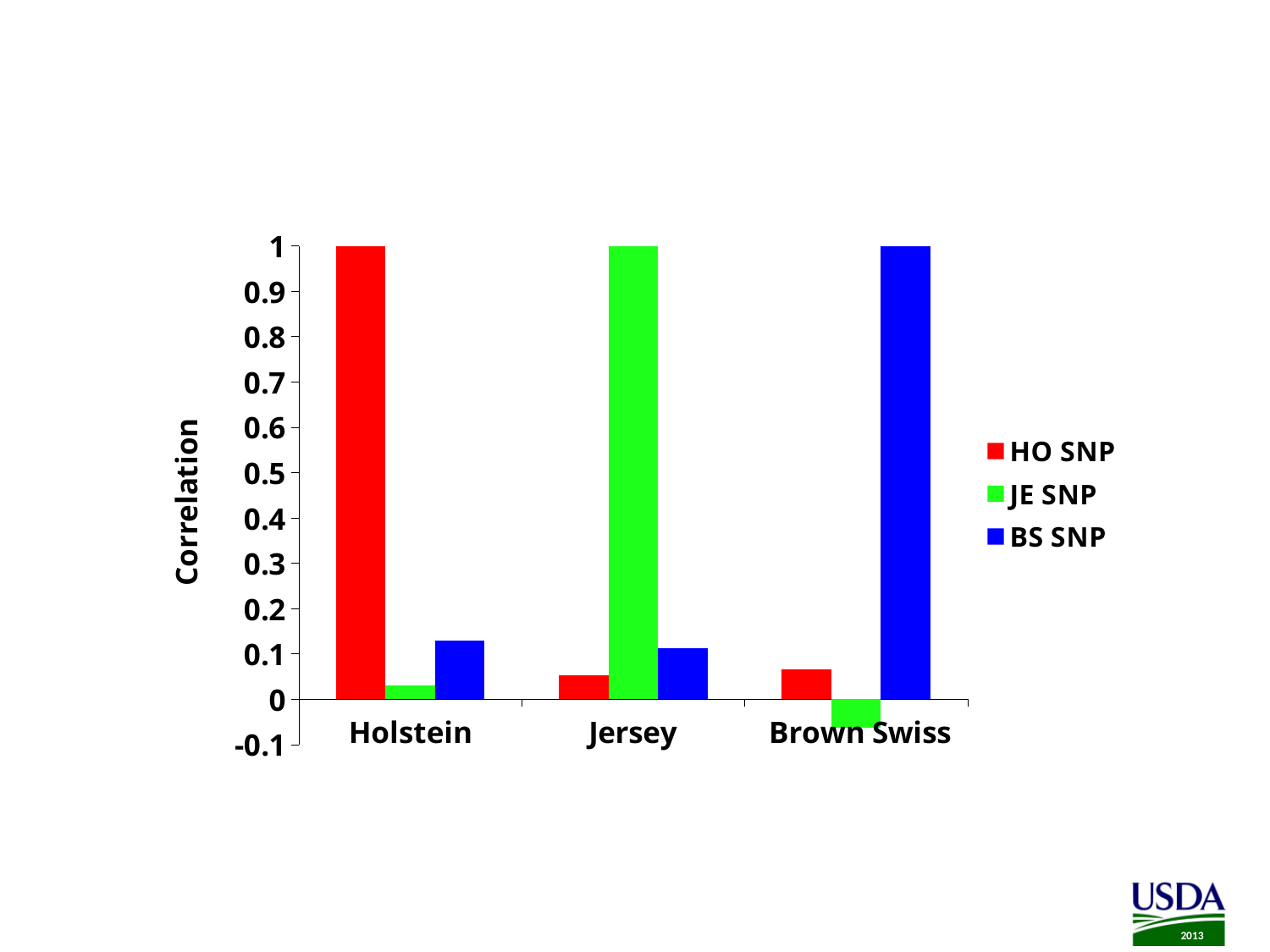
Which series has the highest correlation for Jersey? JE SNP What is the JE SNP correlation for Jersey? 1 How many categories are shown on the x axis? 3 For Holstein, which is larger: the JE SNP correlation or the BS SNP correlation? BS SNP What kind of chart is shown on the slide? bar chart Is the BS SNP correlation for Holstein greater or less than 0.2? less Which series has the lowest correlation for Brown Swiss? JE SNP What is the BS SNP correlation for Brown Swiss? 1 What is the HO SNP correlation for Holstein? 1 How many series does the legend list? 3 Is the JE SNP correlation for Brown Swiss greater or less than 0? less What is the label of the y axis? Correlation